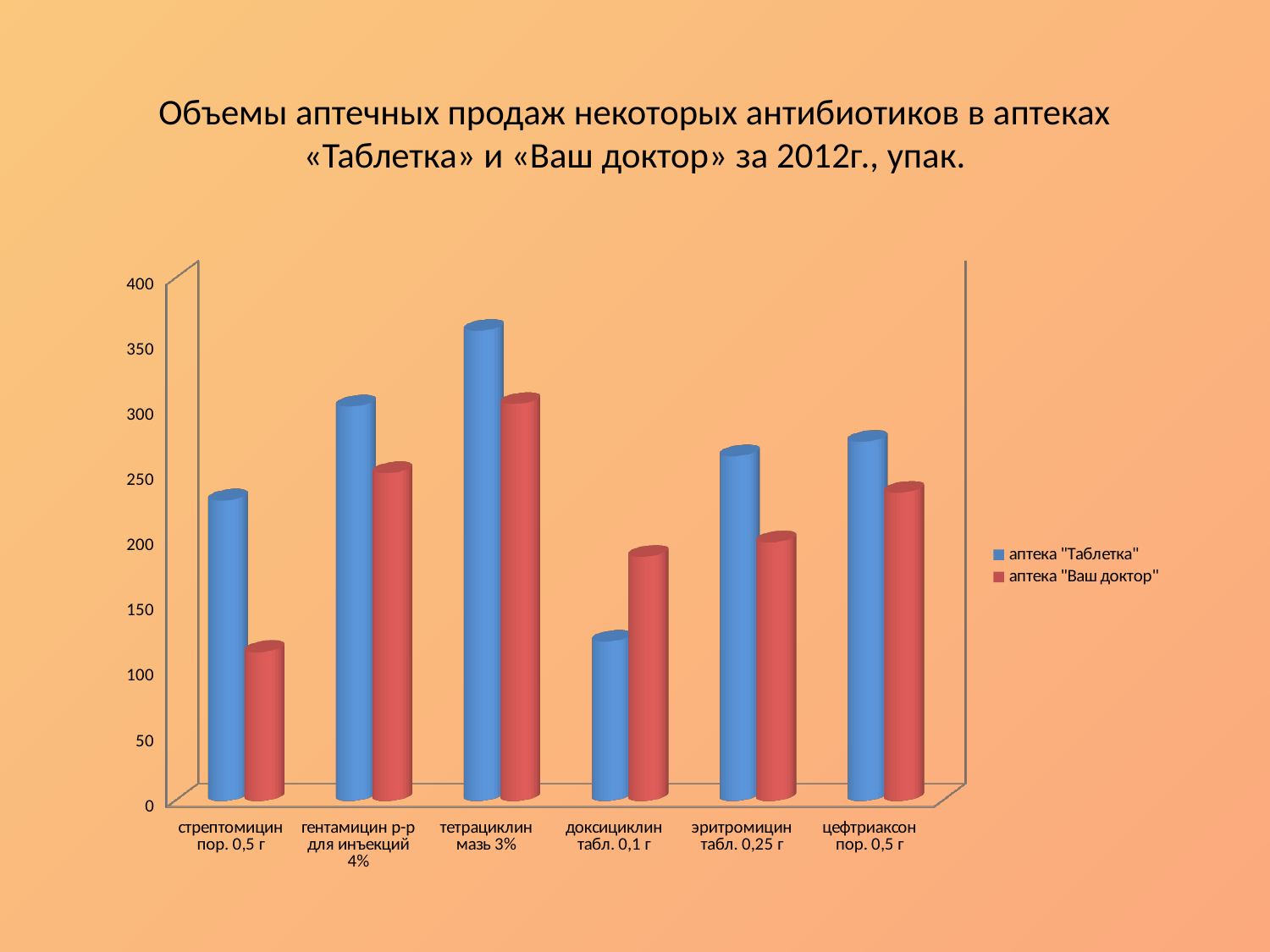
How many antibiotic categories are shown on the x axis? 6 Which antibiotic has the highest sales for аптека "Ваш доктор"? тетрациклин мазь 3% Which antibiotic has the lowest sales for аптека "Ваш доктор"? стрептомицин пор. 0,5 г How many series does the legend list? 2 What kind of chart is shown on the slide? bar chart Which antibiotic has the lowest sales for аптека "Таблетка"? доксициклин табл. 0,1 г Is the value for стрептомицин пор. 0,5 г at аптека "Ваш доктор" greater or less than 150? less For доксициклин табл. 0,1 г, which pharmacy has the larger sales volume? аптека "Ваш доктор" Which antibiotic has the highest sales for аптека "Таблетка"? тетрациклин мазь 3% Is the value for доксициклин табл. 0,1 г at аптека "Таблетка" greater or less than 150? less Which colour represents аптека "Ваш доктор" in the chart? red Is the value for тетрациклин мазь 3% at аптека "Таблетка" greater or less than 300? greater